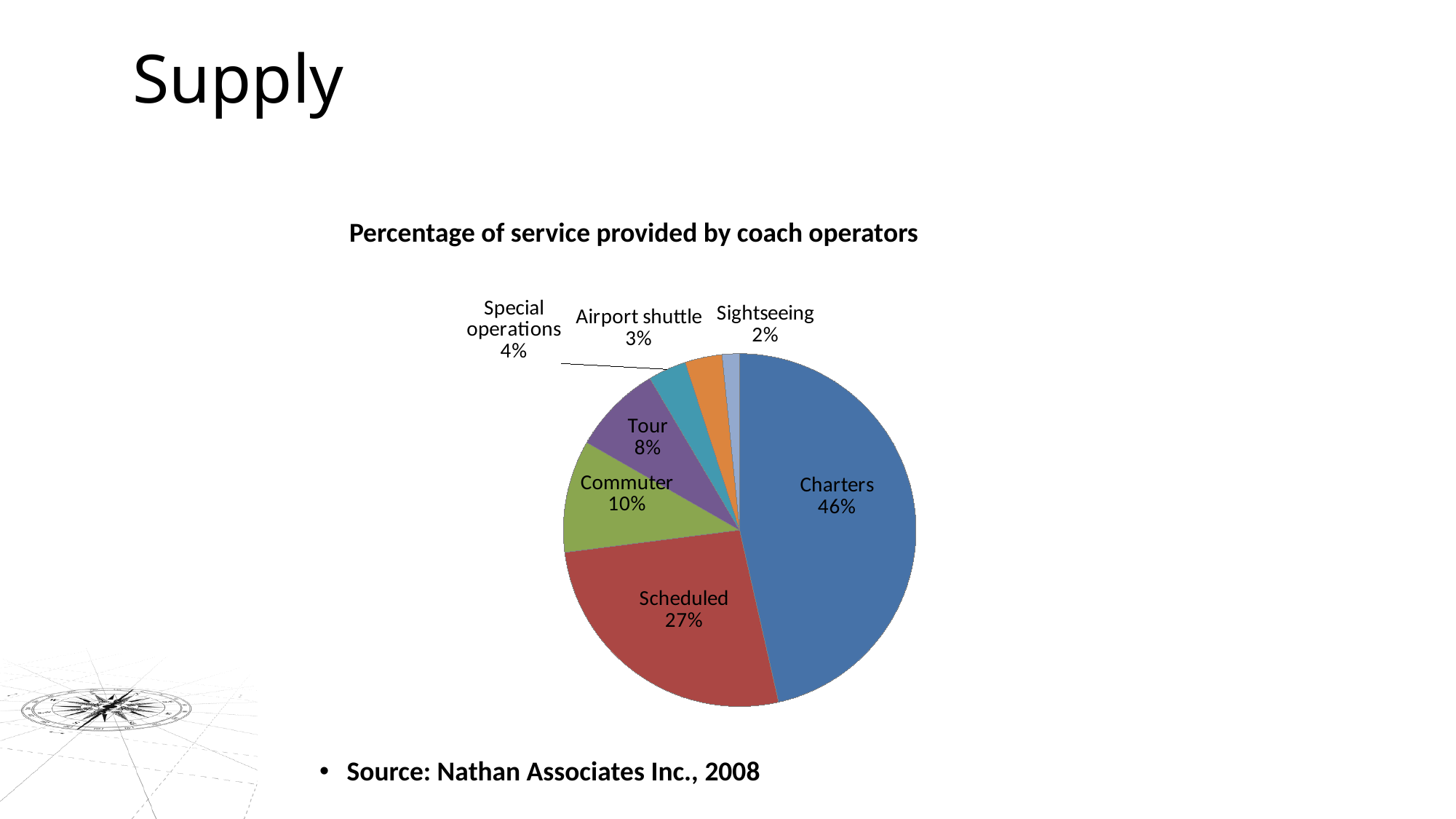
What percentage of service is Airport shuttle? 3% What percentage of service is Scheduled? 27% How many categories are shown in the pie chart? 7 What percentage of service is Commuter? 10% What is the title of the chart? Percentage of service provided by coach operators Which category has the largest share of the pie? Charters What percentage of service is Tour? 8% What percentage of service is provided by Charters? 46% What is the difference in percentage points between Charters and Scheduled? 19 Which category has the smallest share of the pie? Sightseeing What type of chart is shown on the slide? pie chart Which is larger, the share for Commuter or the share for Tour? Commuter